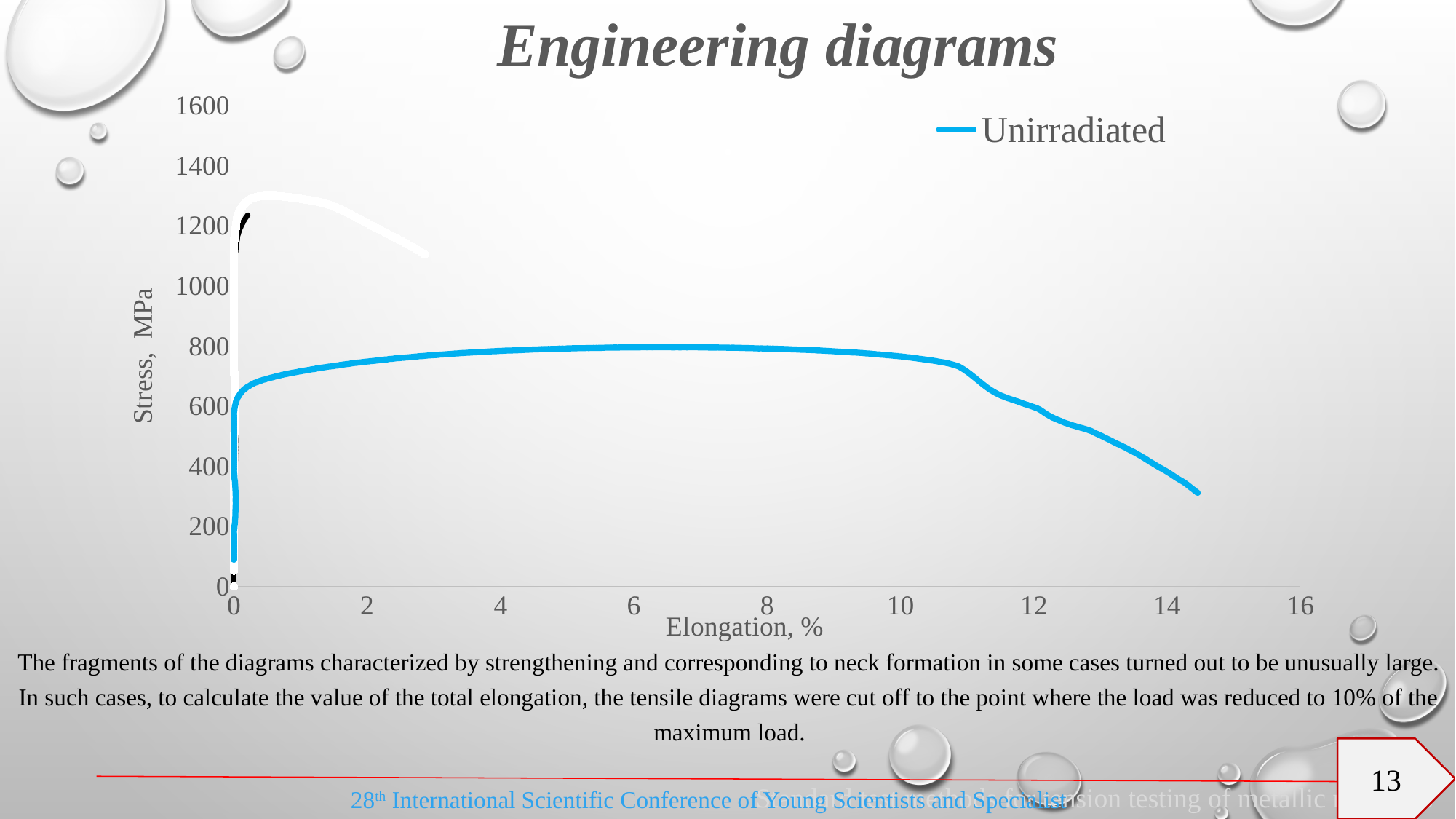
Which curve reaches a higher peak stress, the white curve or the blue Unirradiated curve? the white curve Between 0% and 2% elongation, does the Unirradiated curve rise or fall? rise Is the stress of the Unirradiated curve at 14% elongation greater or less than 600 MPa? less What is the name of the series listed in the legend? Unirradiated Between 12% and 14% elongation, does the Unirradiated curve rise or fall? fall How many series does the chart legend list? 1 Is the maximum stress reached by the Unirradiated curve greater or less than 600 MPa? greater What type of chart is shown on the slide? line chart Is the peak stress of the white curve greater or less than 1000 MPa? greater What is the title of the chart? Engineering diagrams